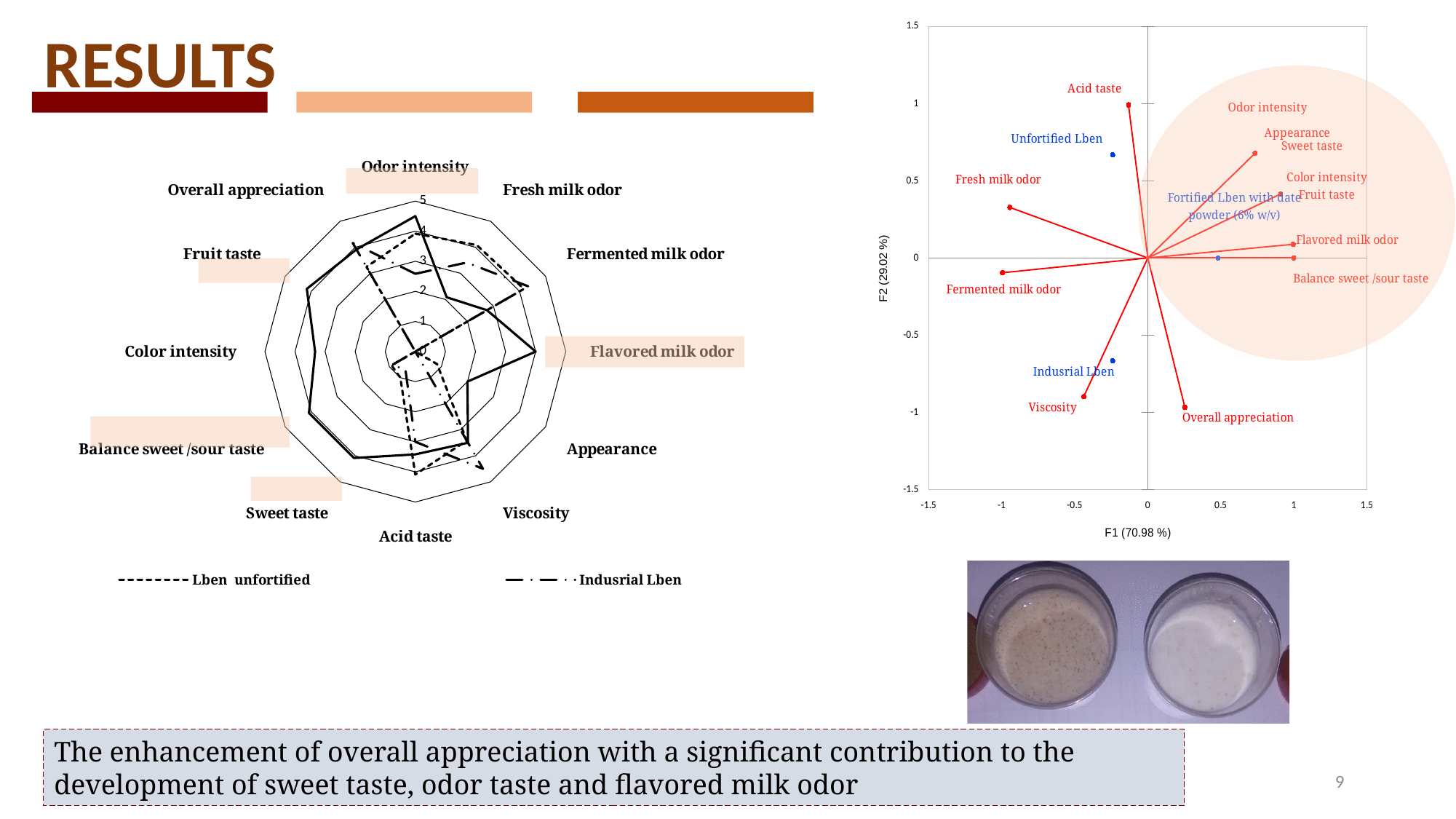
In the scatter chart on the right, how many blue sample points (Lben products) are plotted? 3 In the scatter chart on the right, is the F2 value for Overall appreciation greater or less than -0.5? less How many series does the legend below the radar chart on the left list? 2 How many sensory attributes (axes) does the radar chart on the left have? 12 What is the maximum value shown on the scale of the radar chart on the left? 5 In the scatter chart on the right, which of the blue sample points has the highest F1 value? Fortified Lben with date powder (6% w/v) In the scatter chart on the right, is the F1 value for Fresh milk odor greater or less than -0.5? less In the scatter chart on the right, is the F1 value for Balance sweet /sour taste greater or less than 0.5? greater In the scatter chart on the right, what is the label of the vertical axis? F2 (29.02 %) In the scatter chart on the right, what is the label of the horizontal axis? F1 (70.98 %) What kind of chart is the chart on the left of the slide? radar chart